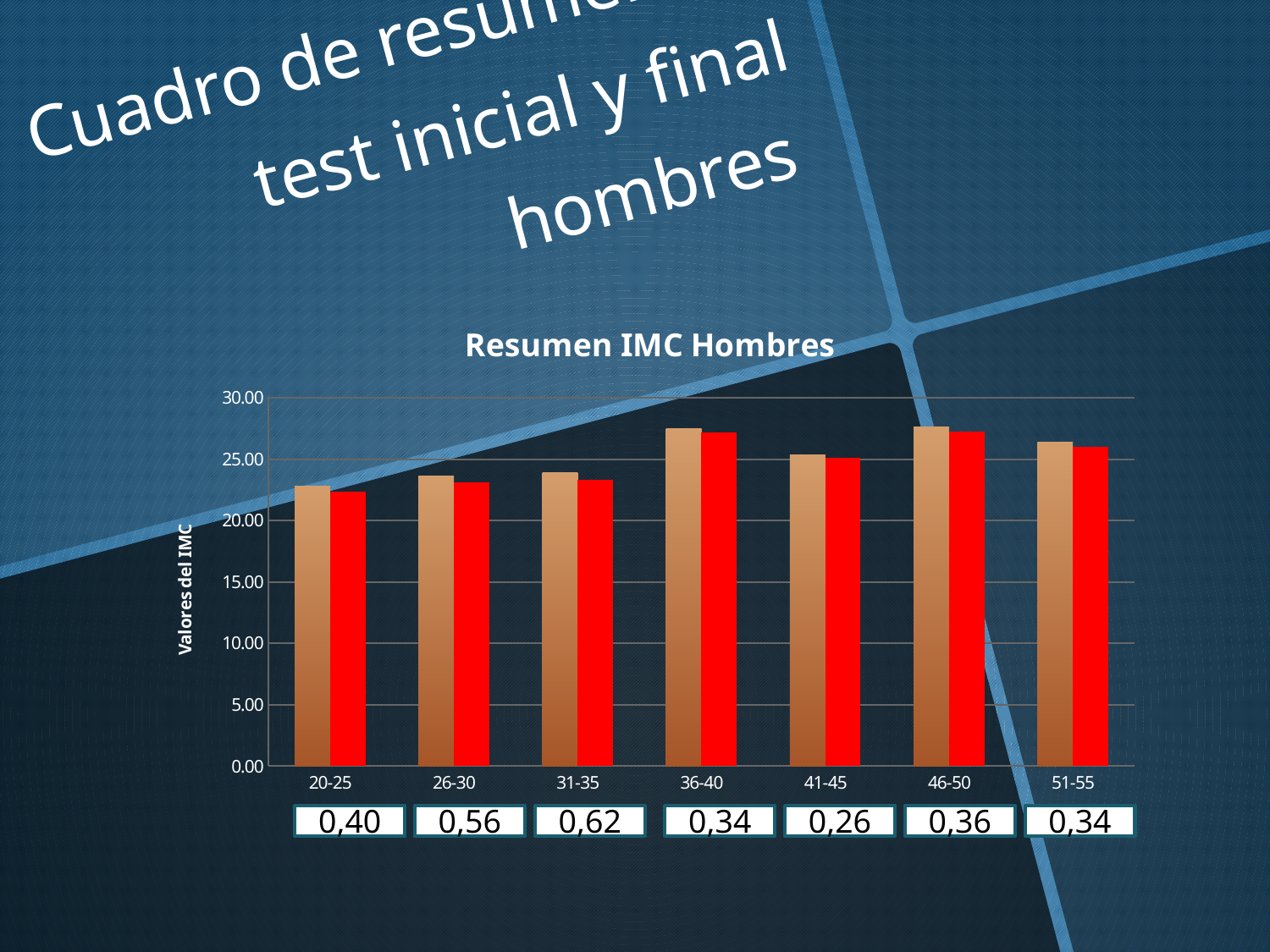
What is the label on the vertical axis of the chart? Valores del IMC Is the value of the brown bar for the 36-40 group greater or less than 25.00? greater What kind of chart is shown on the slide? bar chart How many age-group categories are shown on the x axis of the chart? 7 Is the value of the red bar for the 46-50 group greater or less than 25.00? greater Is the value of the brown bar for the 31-35 group greater or less than 25.00? less How many bars are plotted for each age group in the chart? 2 Which group has the taller red bar, 31-35 or 51-55? 51-55 Which group has the taller brown bar, 20-25 or 36-40? 36-40 What is the title of the chart? Resumen IMC Hombres